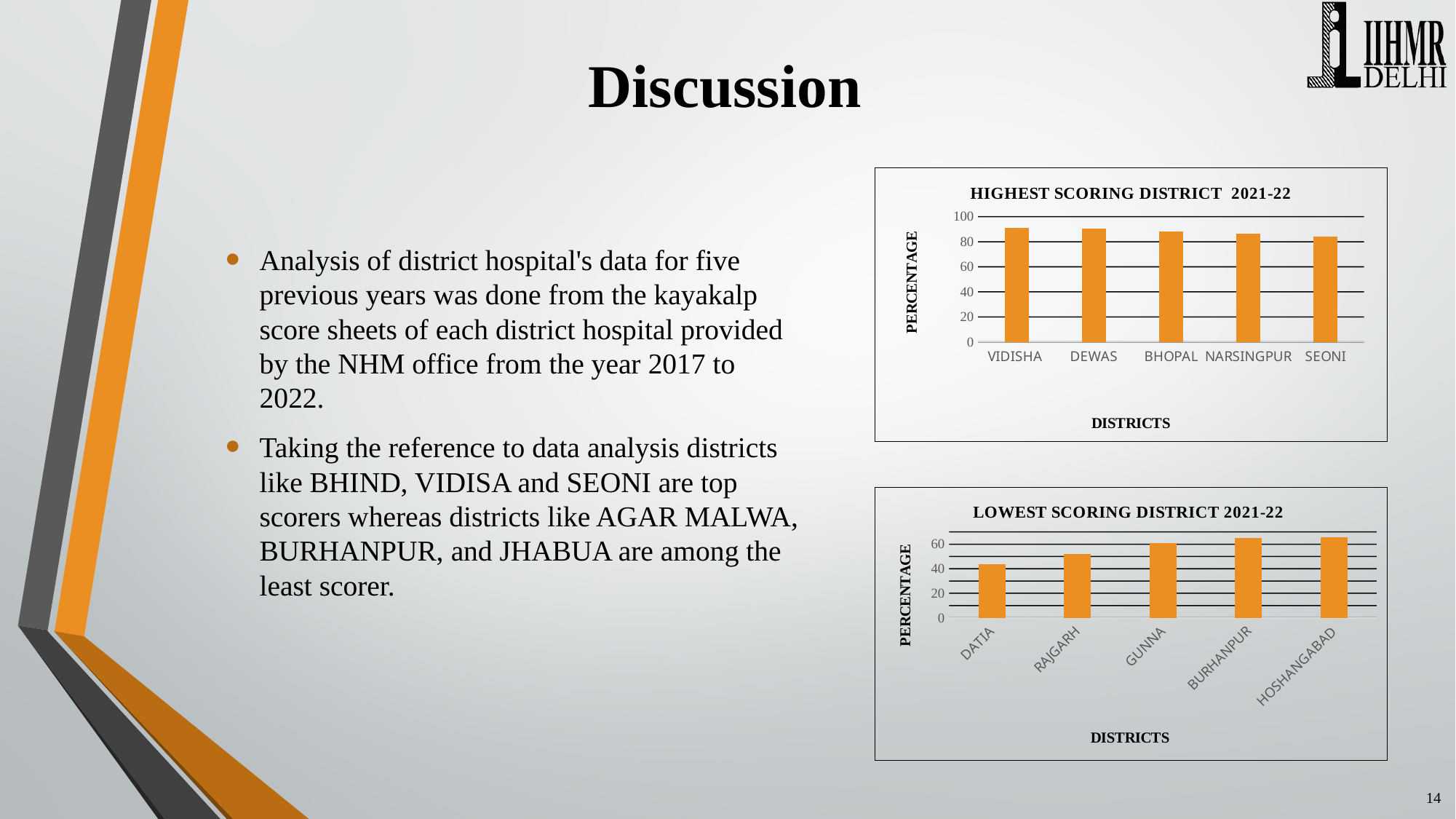
In the 'HIGHEST SCORING DISTRICT 2021-22' chart, which is larger, the value for VIDISHA or the value for SEONI? VIDISHA In the 'HIGHEST SCORING DISTRICT 2021-22' chart, do the values rise or fall from VIDISHA to SEONI? fall How many districts are shown in the 'HIGHEST SCORING DISTRICT 2021-22' chart? 5 In the 'LOWEST SCORING DISTRICT 2021-22' chart, which district has the lowest value? DATIA What is the y-axis label of the 'HIGHEST SCORING DISTRICT 2021-22' chart? PERCENTAGE In the 'LOWEST SCORING DISTRICT 2021-22' chart, do the values rise or fall from DATIA to HOSHANGABAD? rise In the 'LOWEST SCORING DISTRICT 2021-22' chart, is the value for RAJGARH greater or less than 60? less How many districts are shown in the 'LOWEST SCORING DISTRICT 2021-22' chart? 5 What kind of chart is the 'HIGHEST SCORING DISTRICT 2021-22' chart? bar chart In the 'HIGHEST SCORING DISTRICT 2021-22' chart, is the value for VIDISHA greater or less than 80? greater In the 'LOWEST SCORING DISTRICT 2021-22' chart, is the value for DATIA greater or less than 40? greater